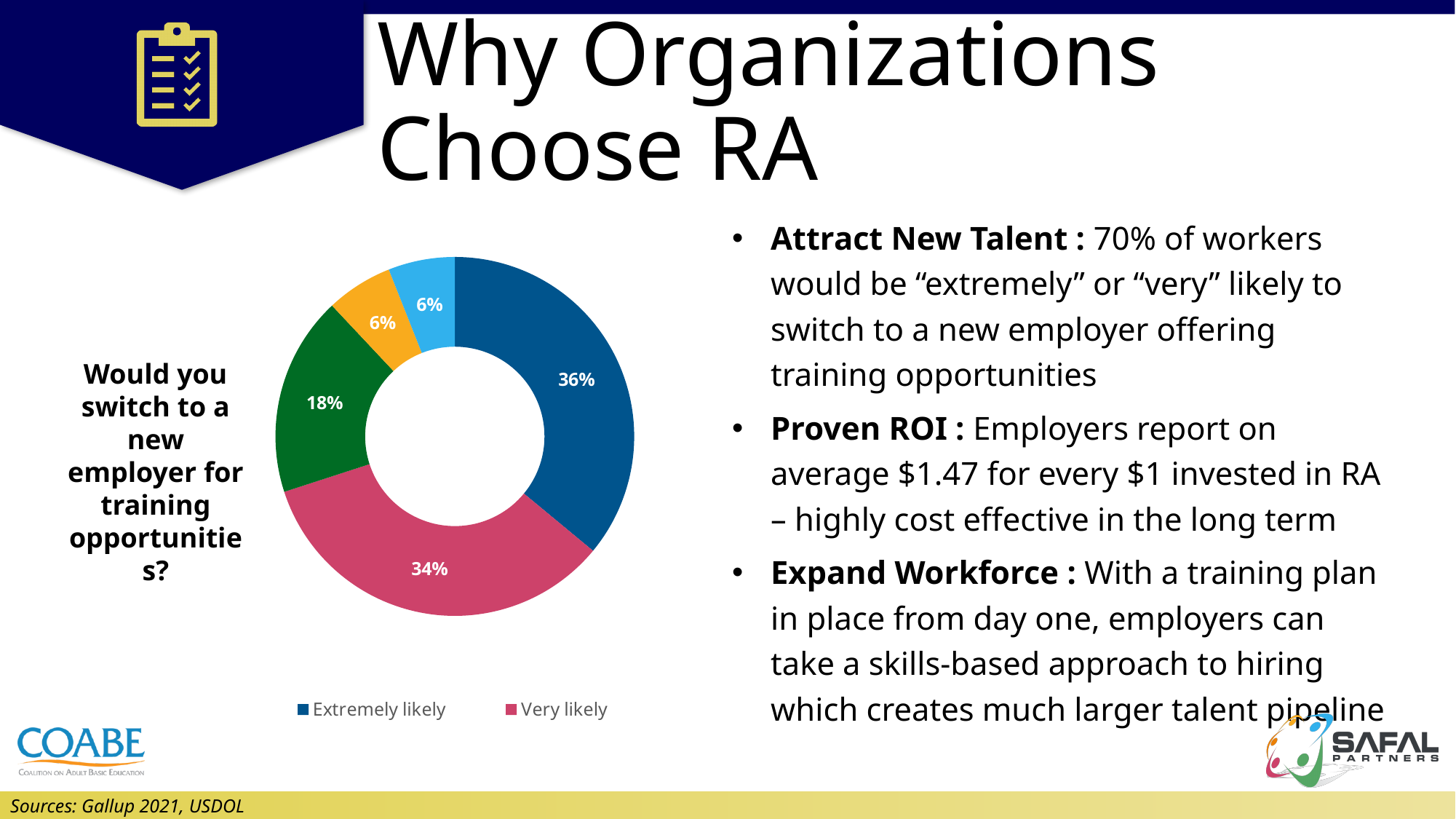
What is the smallest value printed on the pie chart? 6% What value is printed on the green slice of the pie chart? 18% How many entries does the chart legend list? 2 What is the largest value printed on the pie chart? 36% What percentage of the pie chart is labelled "Very likely"? 34% What type of chart is shown on the slide? Pie chart (donut) What percentage of the pie chart is labelled "Extremely likely"? 36% What colour is the "Extremely likely" slice in the pie chart? Blue How many slices does the pie chart have? 5 What is the combined share of the "Extremely likely" and "Very likely" slices? 70% Which of the two legend categories has the larger slice in the pie chart? Extremely likely What is the difference between the "Extremely likely" and "Very likely" slices? 2%